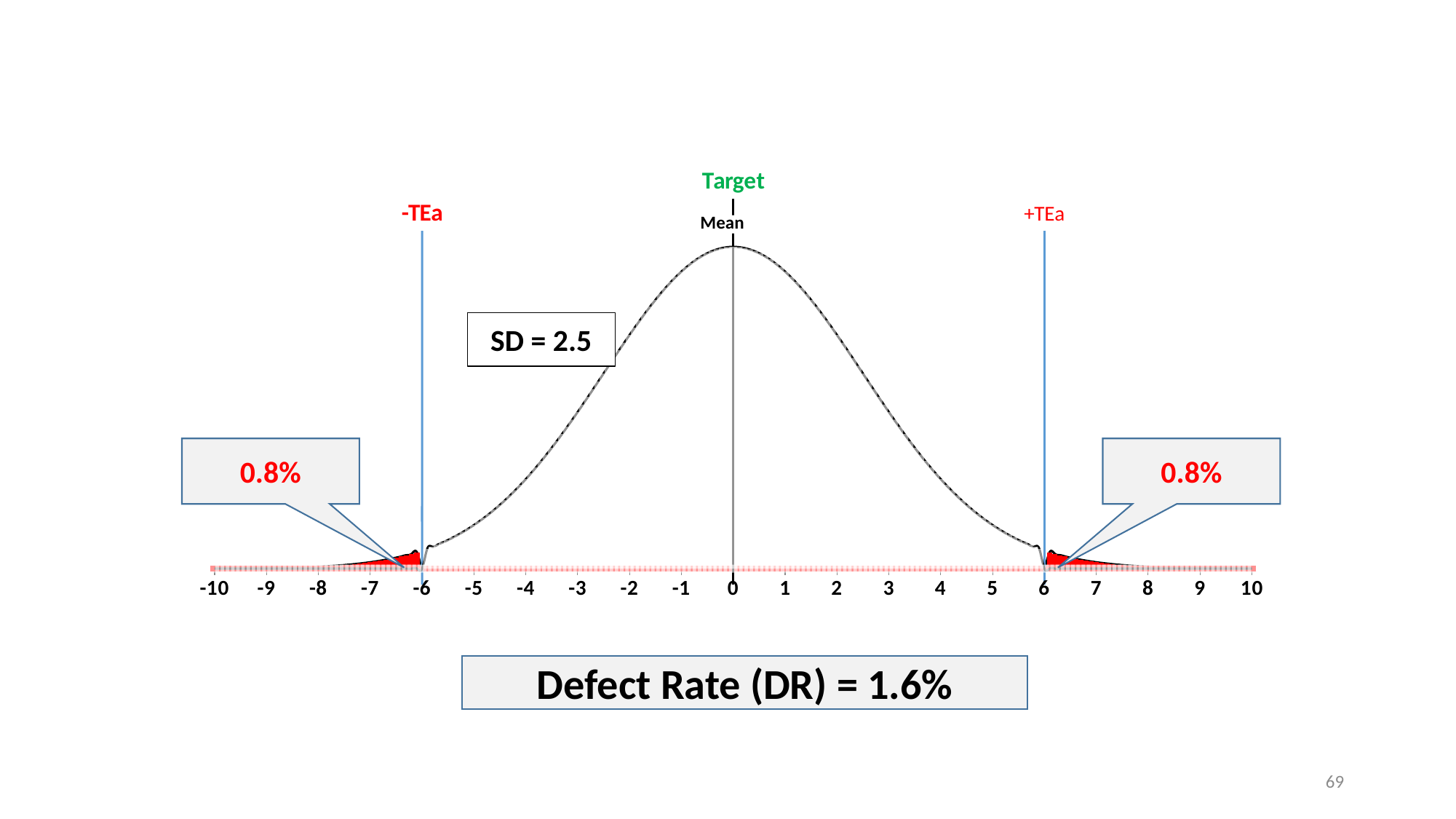
At what x-axis value is the Mean line located? 0 What colour are the shaded tail areas beyond the TEa lines? red At what x-axis value is the +TEa line drawn? 6 Does the curve rise or fall as x increases from 0 to 10? fall What percentage is labelled for the shaded tail beyond -TEa? 0.8% At what x-axis value is the -TEa line drawn? -6 What is the combined percentage of the two shaded tails (0.8% and 0.8%)? 1.6% What is the standard deviation (SD) value shown on the chart? 2.5 What percentage is labelled for the shaded tail beyond +TEa? 0.8% What is the range of the x axis, from its lowest to highest tick? -10 to 10 What is the Defect Rate (DR) stated below the chart? 1.6% What kind of chart is shown on the slide? line chart